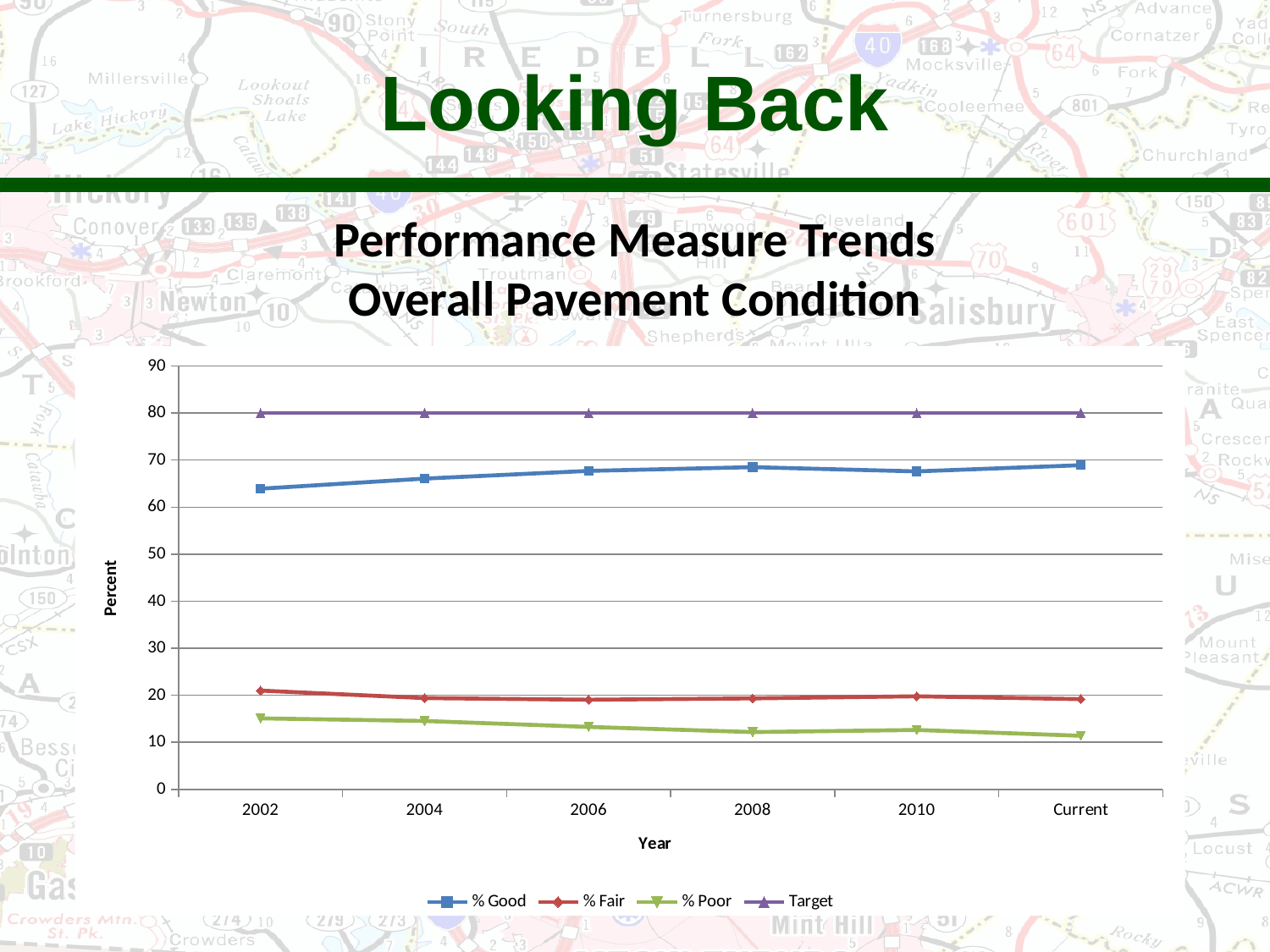
Does the % Poor series generally rise or fall from 2002 to Current? fall How many series does the legend list? 4 Is the value for % Poor at Current greater or less than 20? less Is the value for % Fair in 2006 greater or less than 30? less What is the value of the Target series in 2008? 80 What kind of chart is shown on the slide? line chart Is the value for % Good in 2002 greater or less than 60? greater Which series has the lowest value at Current? % Poor Which series has the highest value in 2002? Target How many points are shown along the Year axis? 6 Which is larger in 2010, % Good or % Fair? % Good What is the label on the vertical axis? Percent